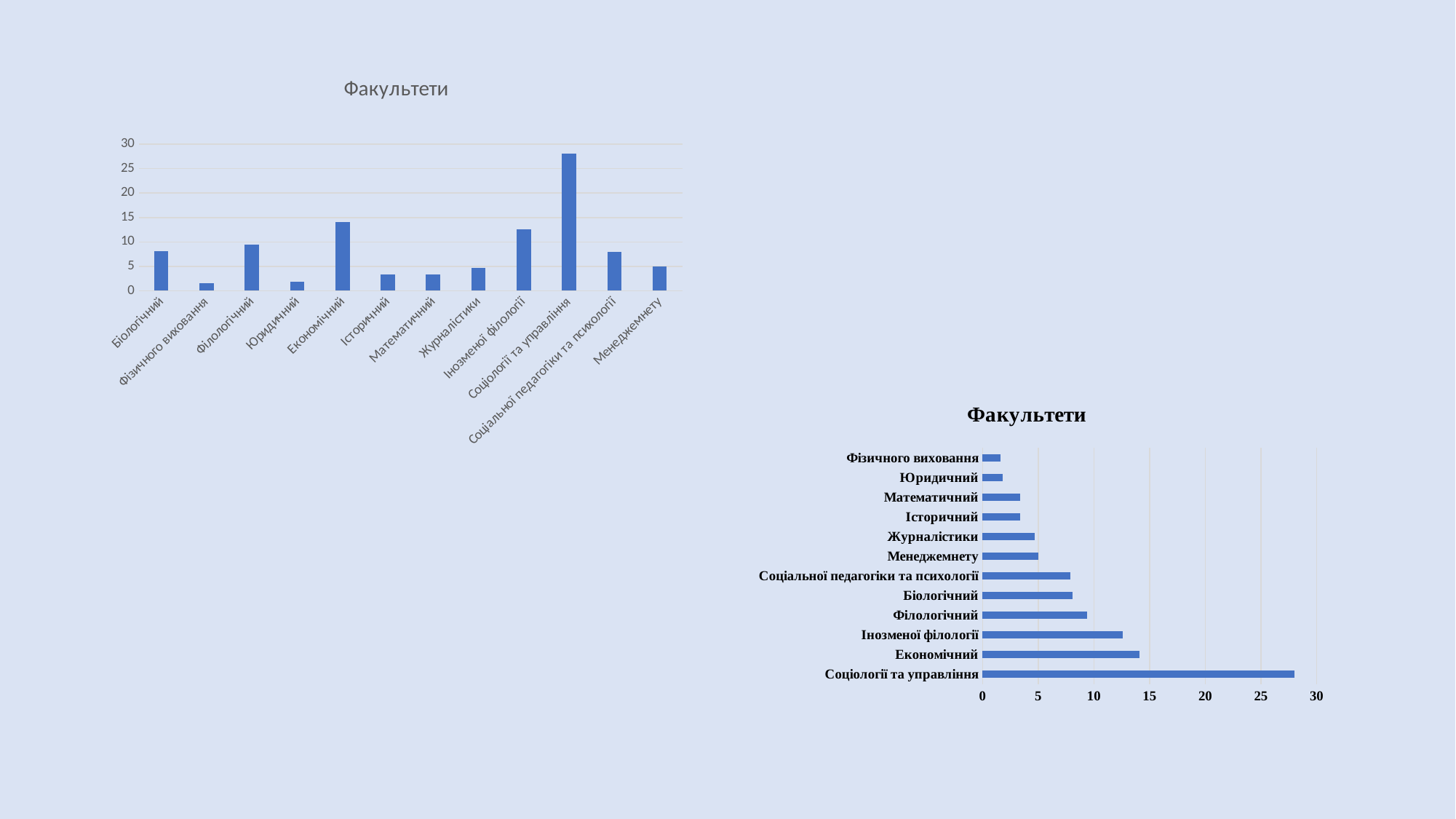
In the bottom-right chart, which is larger, the value for Журналістики or the value for Біологічний? Біологічний What is the title of the top-left chart? Факультети In the top-left chart, is the value for Юридичний greater or less than 5? less In the bottom-right chart, is the value for Економічний greater or less than 10? greater In the bottom-right chart, which faculty has the lowest value? Фізичного виховання What kind of chart is the chart in the top-left of the slide? bar chart In the top-left chart, which is larger, the value for Економічний or the value for Філологічний? Економічний In the top-left chart, which faculty has the highest value? Соціології та управління In the top-left chart, is the value for Соціології та управління greater or less than 25? greater What kind of chart is the chart in the bottom-right of the slide? bar chart How many faculties are shown in the bottom-right chart? 12